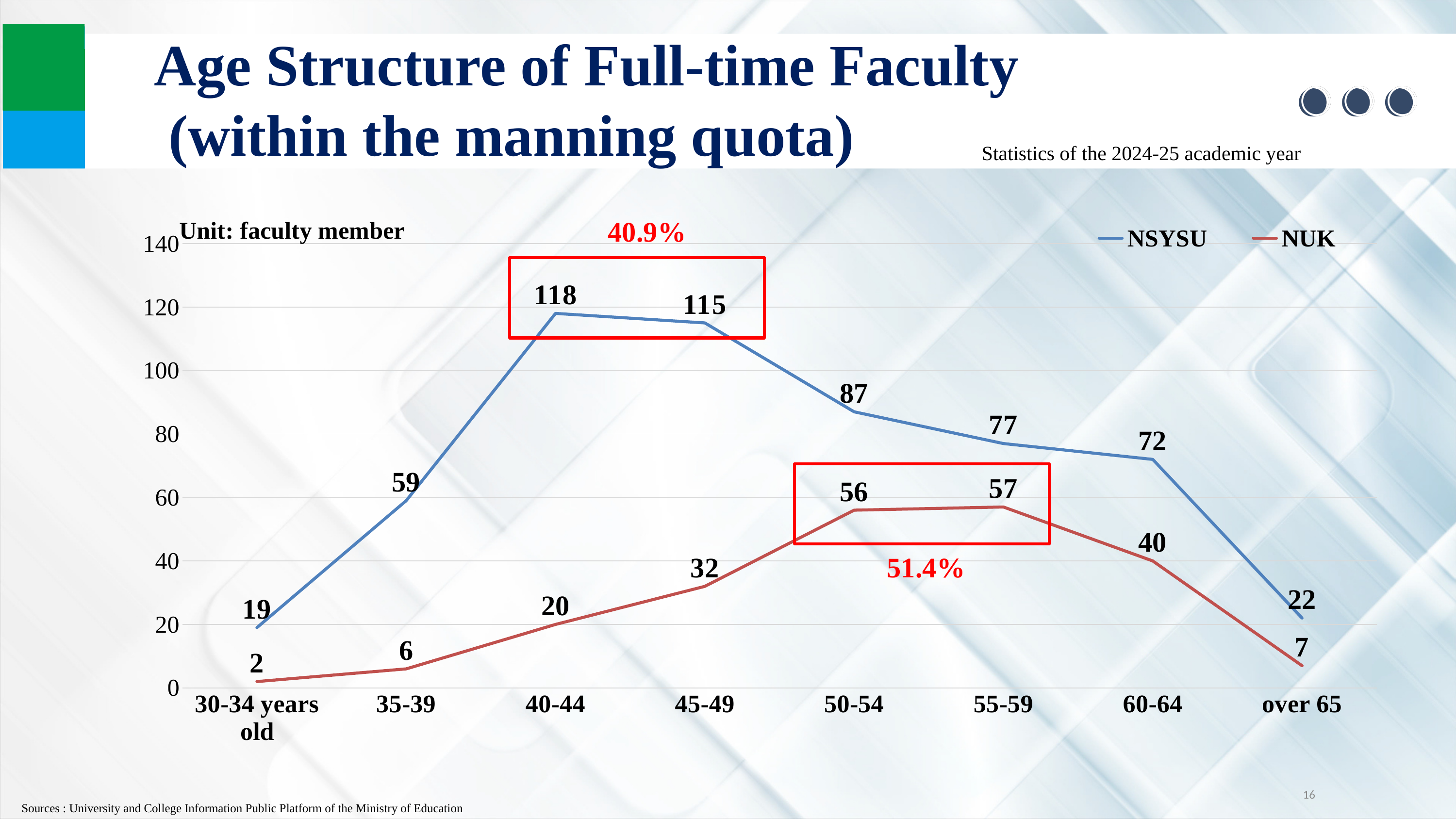
What unit is stated for the chart values? faculty member Which age group has the highest NUK value? 55-59 Does the NUK line rise or fall from the 30-34 age group to the 55-59 age group? Rise What is the NUK value for the 50-54 age group? 56 What is the NSYSU value for the over 65 age group? 22 Which age group has the lowest NSYSU value? 30-34 years old Which is larger for the 60-64 age group, the NSYSU value or the NUK value? NSYSU What is the NSYSU value for the 40-44 age group? 118 How many age groups are shown on the x axis? 8 What is the difference between the NSYSU and NUK values for the 45-49 age group? 83 What kind of chart is shown on the slide? Line chart How many series does the legend list? 2